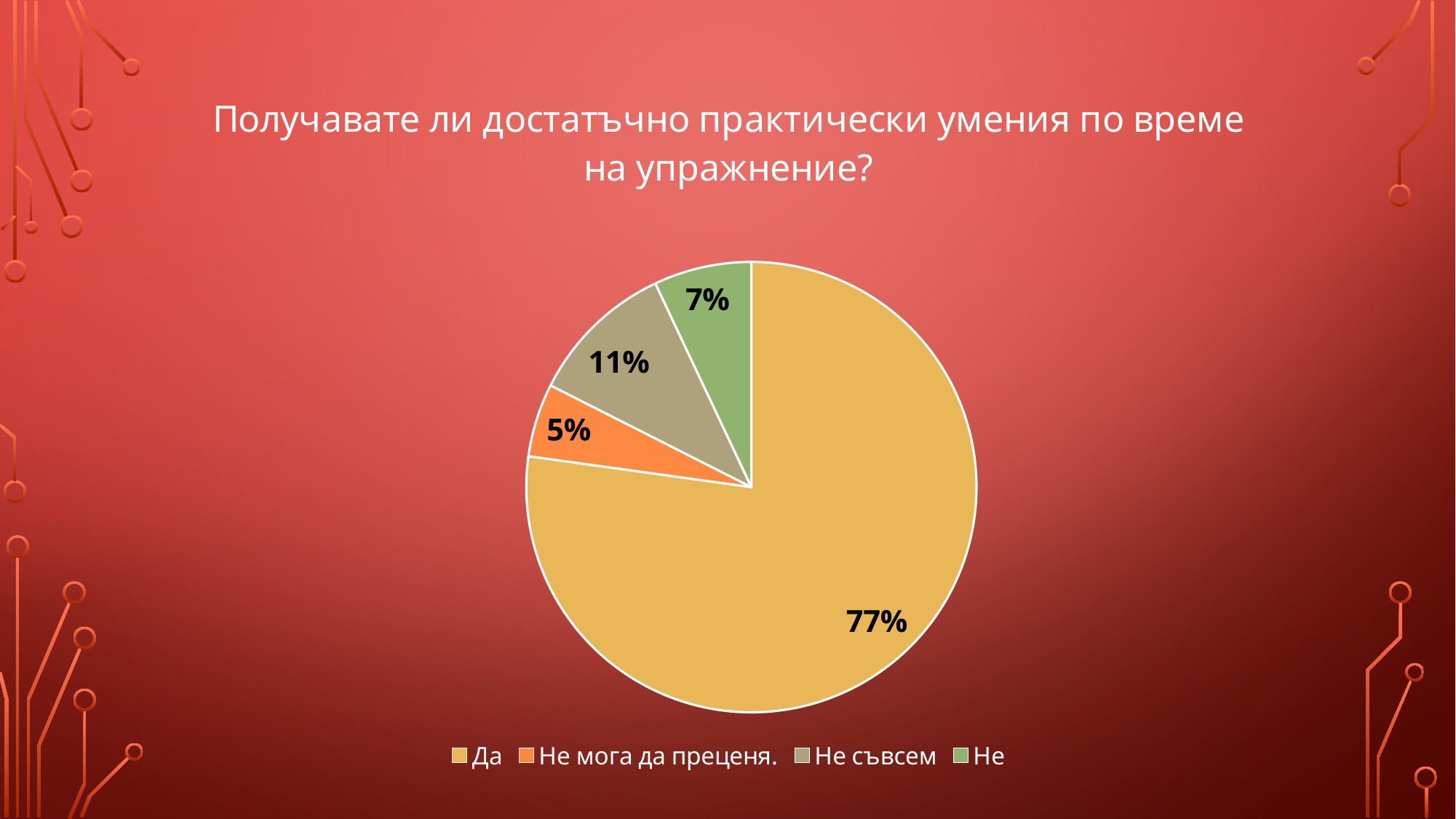
What kind of chart is shown on the slide? pie chart Which category has the largest slice of the pie? Да What share of the pie does "Не" have? 7% What is the difference in percentage points between "Да" and "Не съвсем"? 66 What share of the pie does "Не мога да преценя." have? 5% How many slices does the pie chart have? 4 What share of the pie does "Да" have? 77% Which category has the smallest slice of the pie? Не мога да преценя. What colour is the slice for "Не"? green Which is larger, the slice for "Не съвсем" or the slice for "Не"? Не съвсем What is the title of the chart? Получавате ли достатъчно практически умения по време на упражнение?